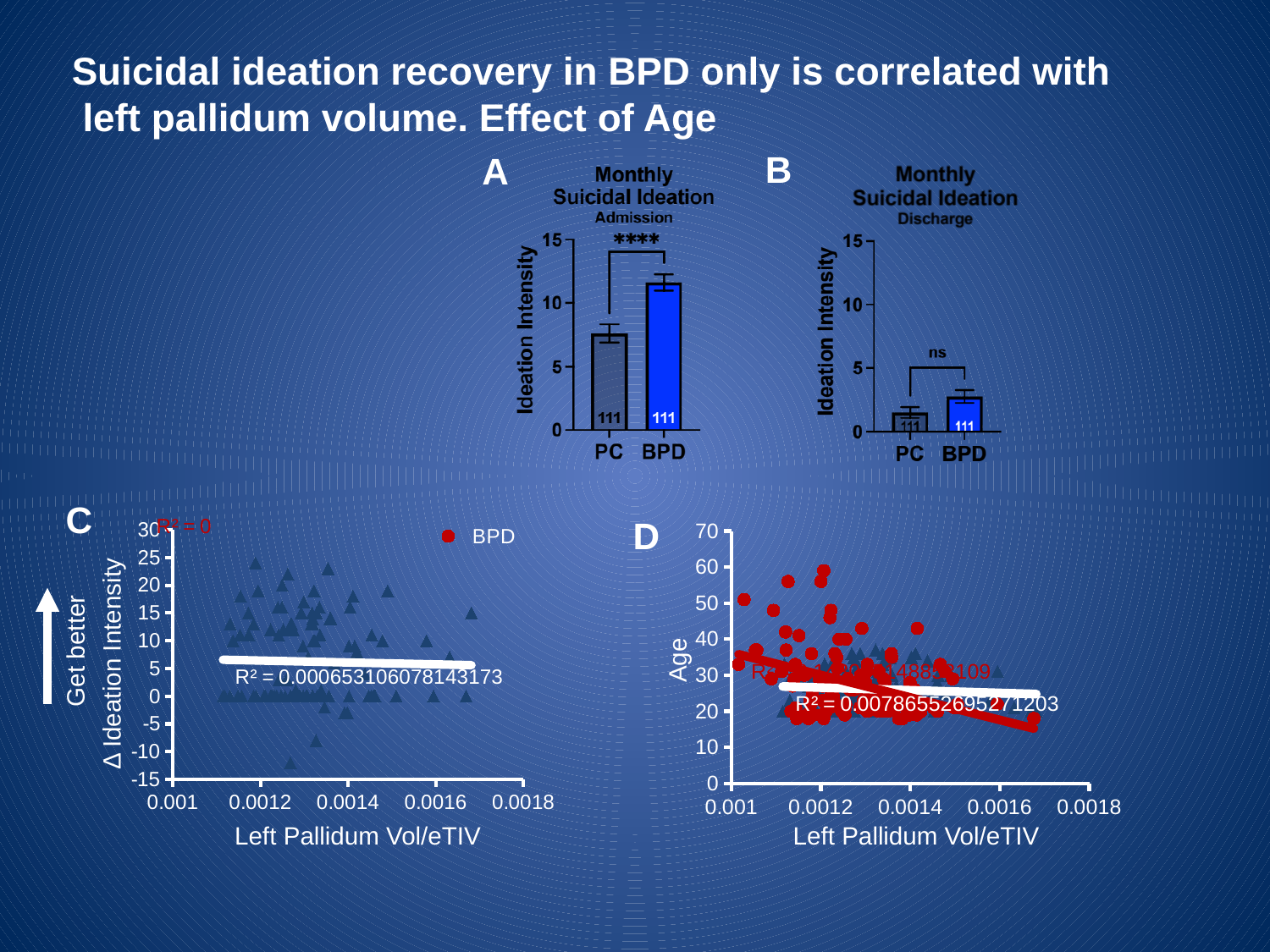
In chart A (Monthly Suicidal Ideation Admission), is the value for PC greater or less than 10? less What R² value is printed in white on chart C (bottom left)? R² = 0.000653106078143173 In chart A (Monthly Suicidal Ideation Admission), which group has the higher ideation intensity, PC or BPD? BPD What is the x-axis label of chart C (bottom left)? Left Pallidum Vol/eTIV In chart B (Monthly Suicidal Ideation Discharge), which group has the higher ideation intensity, PC or BPD? BPD In chart D (bottom right), does the white trend line rise or fall as Left Pallidum Vol/eTIV increases? fall What kind of chart is chart C (bottom left)? scatter chart What R² value is printed in white on chart D (bottom right)? R² = 0.00786552695271203 What kind of chart is chart A (Monthly Suicidal Ideation Admission)? bar chart In chart B (Monthly Suicidal Ideation Discharge), is the value for BPD greater or less than 5? less How many categories are shown on the x axis of chart A (Monthly Suicidal Ideation Admission)? 2 In chart A (Monthly Suicidal Ideation Admission), is the value for BPD greater or less than 10? greater